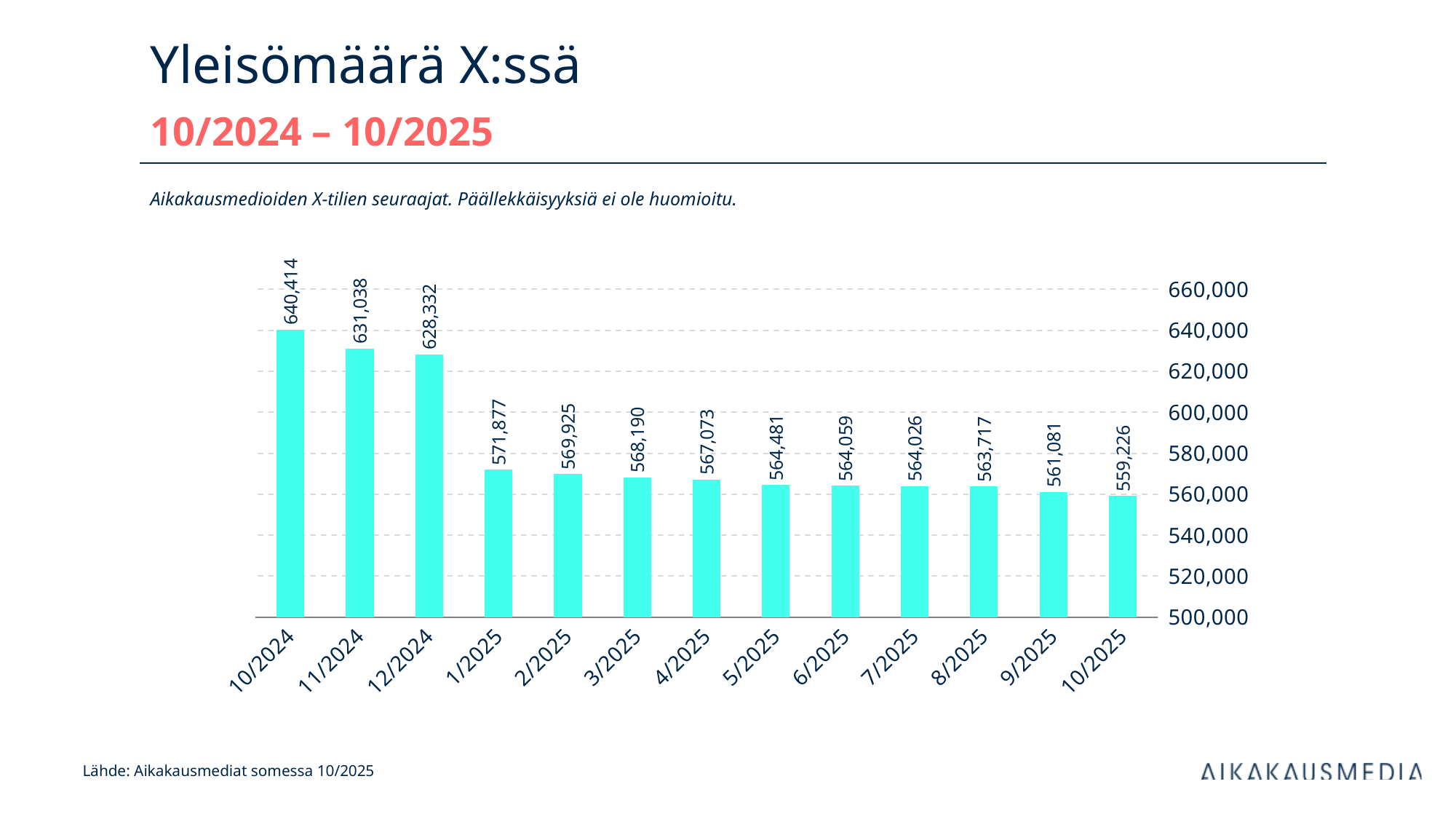
What is the difference between the values for 12/2024 and 1/2025? 56,455 Which month has the highest value? 10/2024 What is the value for 10/2024? 640,414 What is the value for 1/2025? 571,877 Is the value for 9/2025 greater or less than 580,000? less Do the values generally rise or fall from 10/2024 to 10/2025? fall Which is larger, the value for 11/2024 or the value for 12/2024? 11/2024 How many months are shown on the x axis? 13 What is the difference between the values for 10/2024 and 10/2025? 81,188 What is the value for 10/2025? 559,226 Which month has the lowest value? 10/2025 What kind of chart is shown on the slide? bar chart